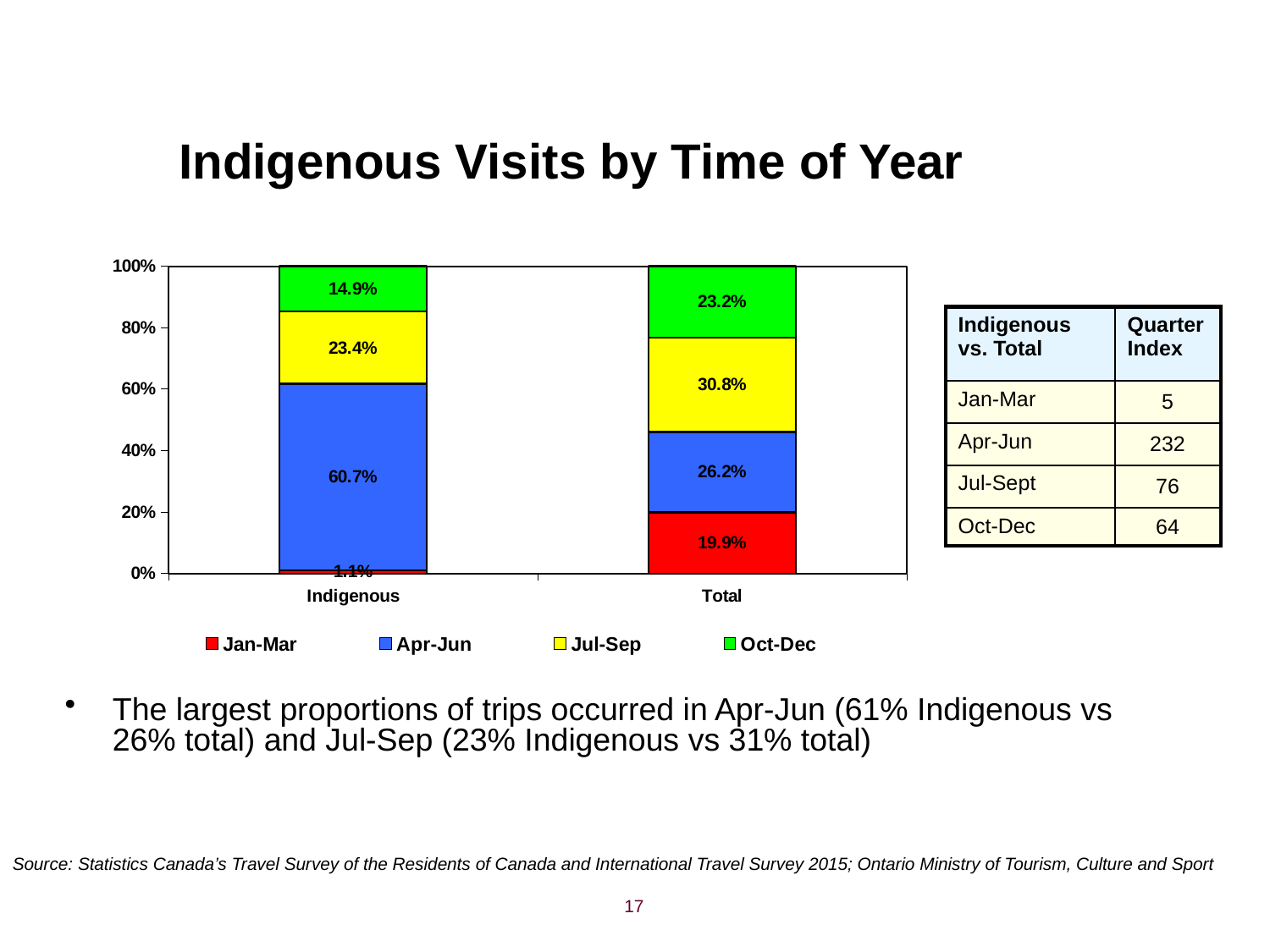
Which quarter has the smallest share of the Total bar? Jan-Mar What is the difference between the Apr-Jun values for Indigenous and Total? 34.5% What kind of chart is shown on the slide? Stacked bar chart What is the Oct-Dec value for the Total bar? 23.2% Which quarter has the largest share of the Indigenous bar? Apr-Jun What is the Jul-Sep value for the Total bar? 30.8% How many series does the legend list? 4 What is the Apr-Jun value for the Indigenous bar? 60.7% Which is larger, the Oct-Dec value for Indigenous or for Total? Total Which colour represents Jul-Sep in the chart? Yellow How many categories are shown on the x axis? 2 What is the Jan-Mar value for the Indigenous bar? 1.1%